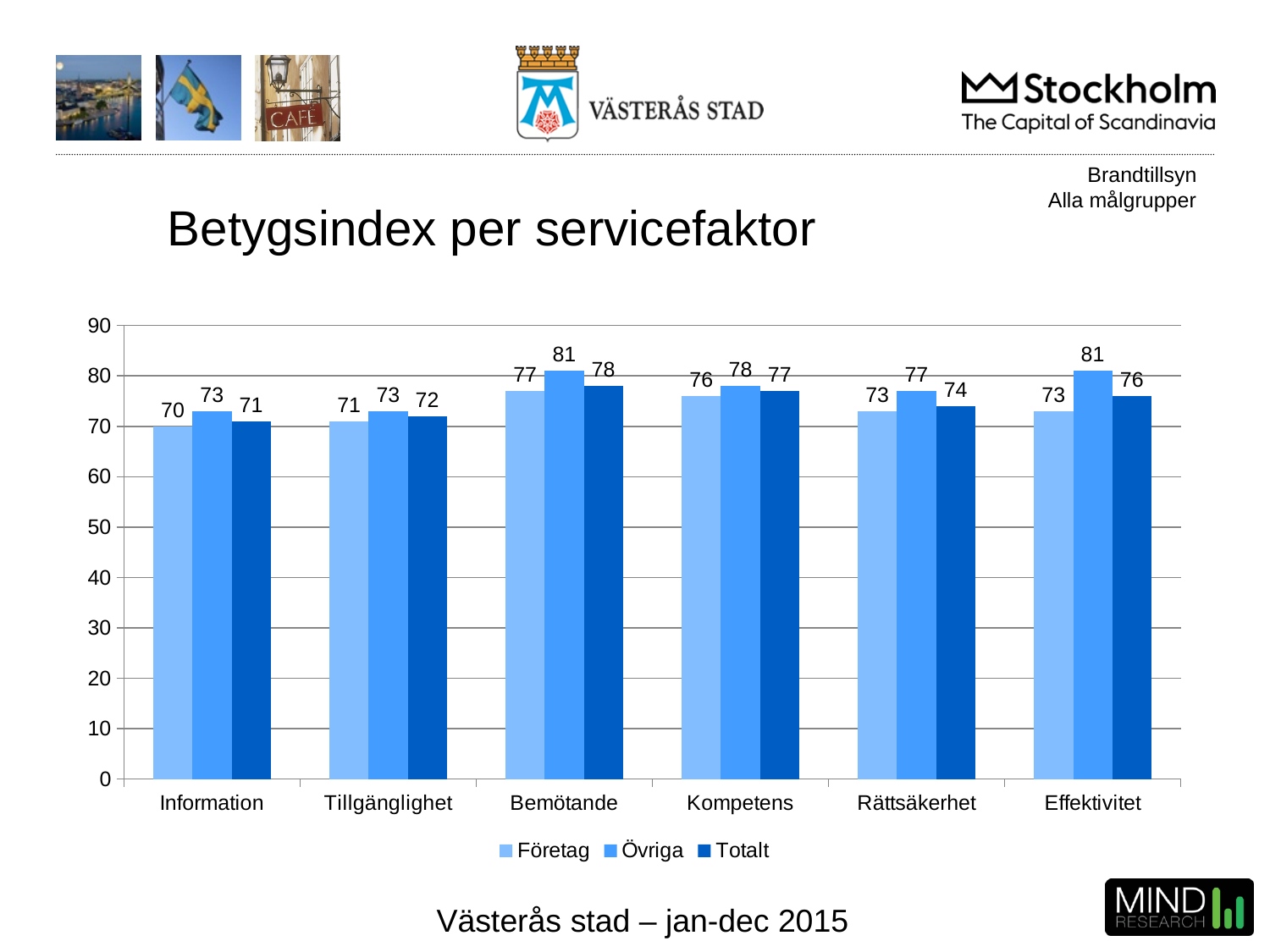
What kind of chart is shown on the slide? bar chart How many categories are shown on the x axis? 6 Which category has the lowest Totalt value? Information What is the Övriga value for Effektivitet? 81 What is the difference between the Övriga and Företag values for Effektivitet? 8 What is the Totalt value for Bemötande? 78 Which is larger for Kompetens: the Företag value or the Övriga value? Övriga Is the Totalt value for Rättsäkerhet greater or less than 70? greater What is the Företag value for Information? 70 Which category has the highest Totalt value? Bemötande What is the title of the chart? Betygsindex per servicefaktor How many series does the legend list? 3